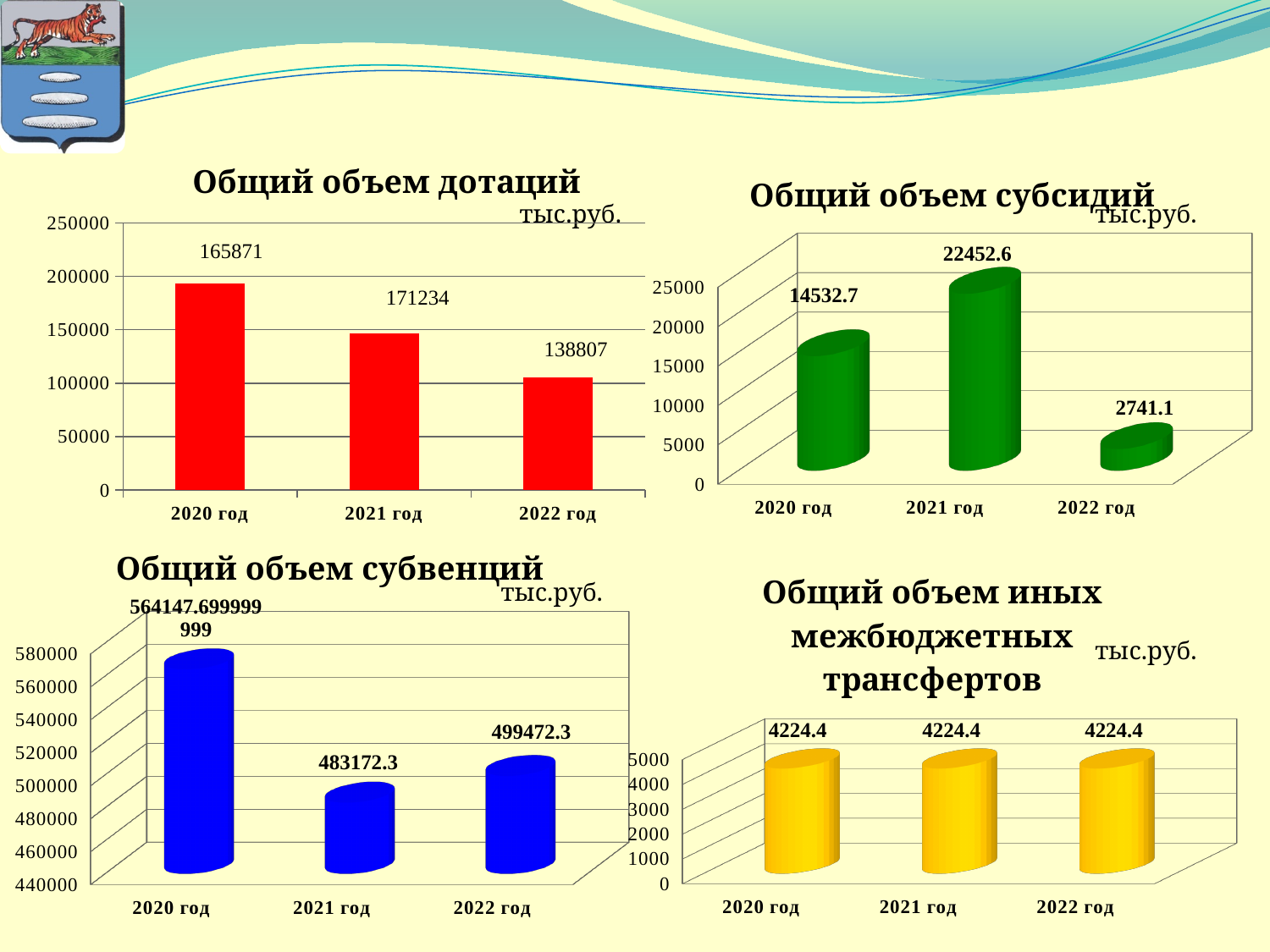
How many categories are shown on the x axis of the chart 'Общий объем дотаций'? 3 In the chart 'Общий объем дотаций', what is the value for 2021 год? 171234 In the chart 'Общий объем субсидий', what is the value for 2020 год? 14532.7 In the chart 'Общий объем субсидий', what is the difference between the values for 2021 год and 2020 год? 7919.9 In the chart 'Общий объем иных межбюджетных трансфертов', what is the value for 2022 год? 4224.4 In the chart 'Общий объем дотаций', what is the value for 2022 год? 138807 In the chart 'Общий объем субвенций', which is larger, the value for 2021 год or 2022 год? 2022 год In the chart 'Общий объем субсидий', which year has the highest value? 2021 год In the chart 'Общий объем субсидий', which year has the lowest value? 2022 год In the chart 'Общий объем субвенций', which year has the highest value? 2020 год In the chart 'Общий объем субвенций', what is the value for 2021 год? 483172.3 In the chart 'Общий объем иных межбюджетных трансфертов', do the values rise, fall or stay the same across the years? stay the same